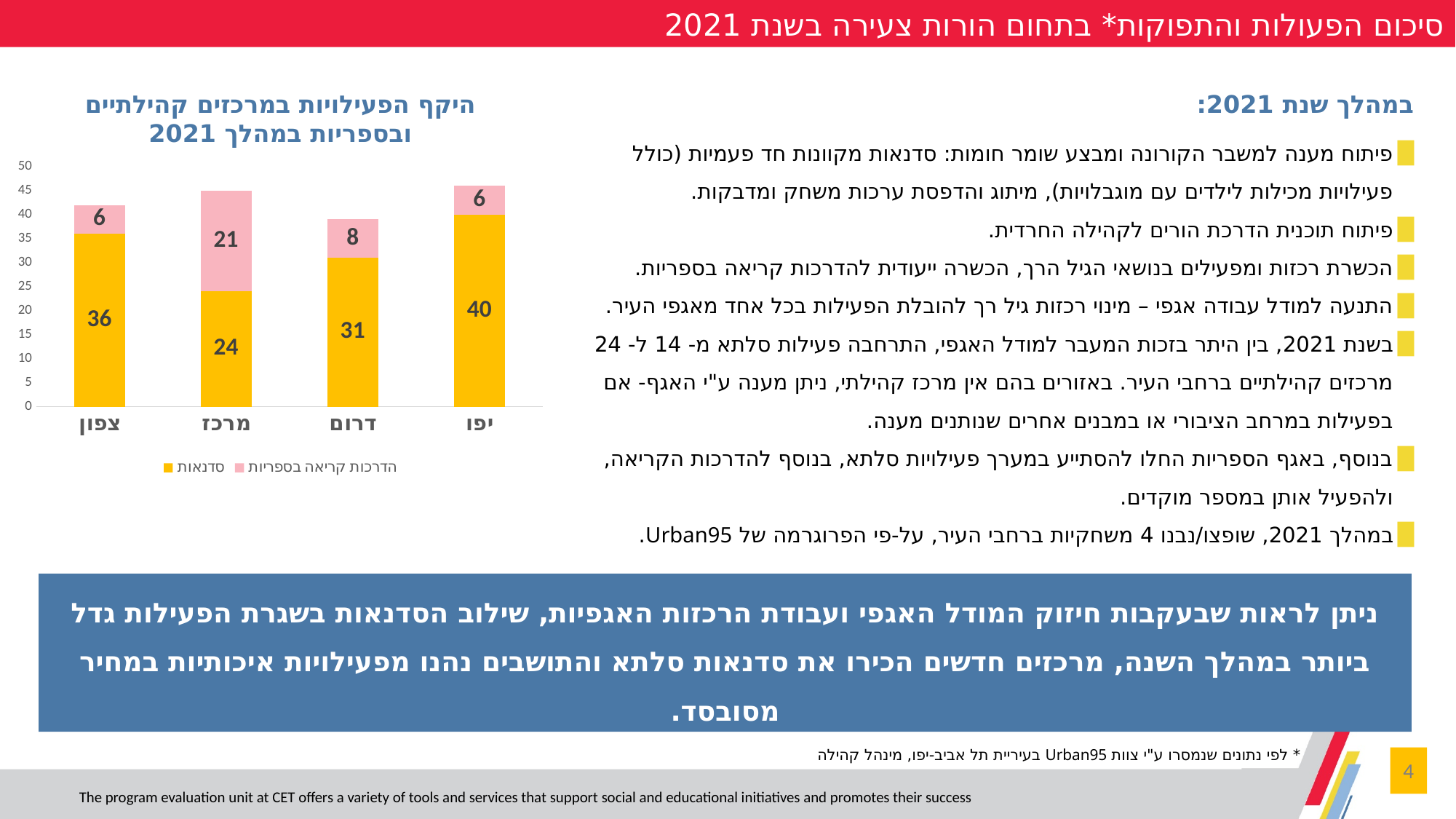
What is the total of the stacked bar for מרכז? 45 How many series does the legend list? 2 Which category has the highest value for סדנאות? יפו What is the value of הדרכות קריאה בספריות for מרכז? 21 Which is larger: the סדנאות value for דרום or for צפון? צפון What kind of chart is shown on the slide? Stacked bar chart How many categories are shown on the x axis? 4 Which category has the lowest value for סדנאות? מרכז What is the difference between the סדנאות values for יפו and מרכז? 16 What is the value of סדנאות for צפון? 36 What is the value of סדנאות for יפו? 40 Which category has the highest value for הדרכות קריאה בספריות? מרכז